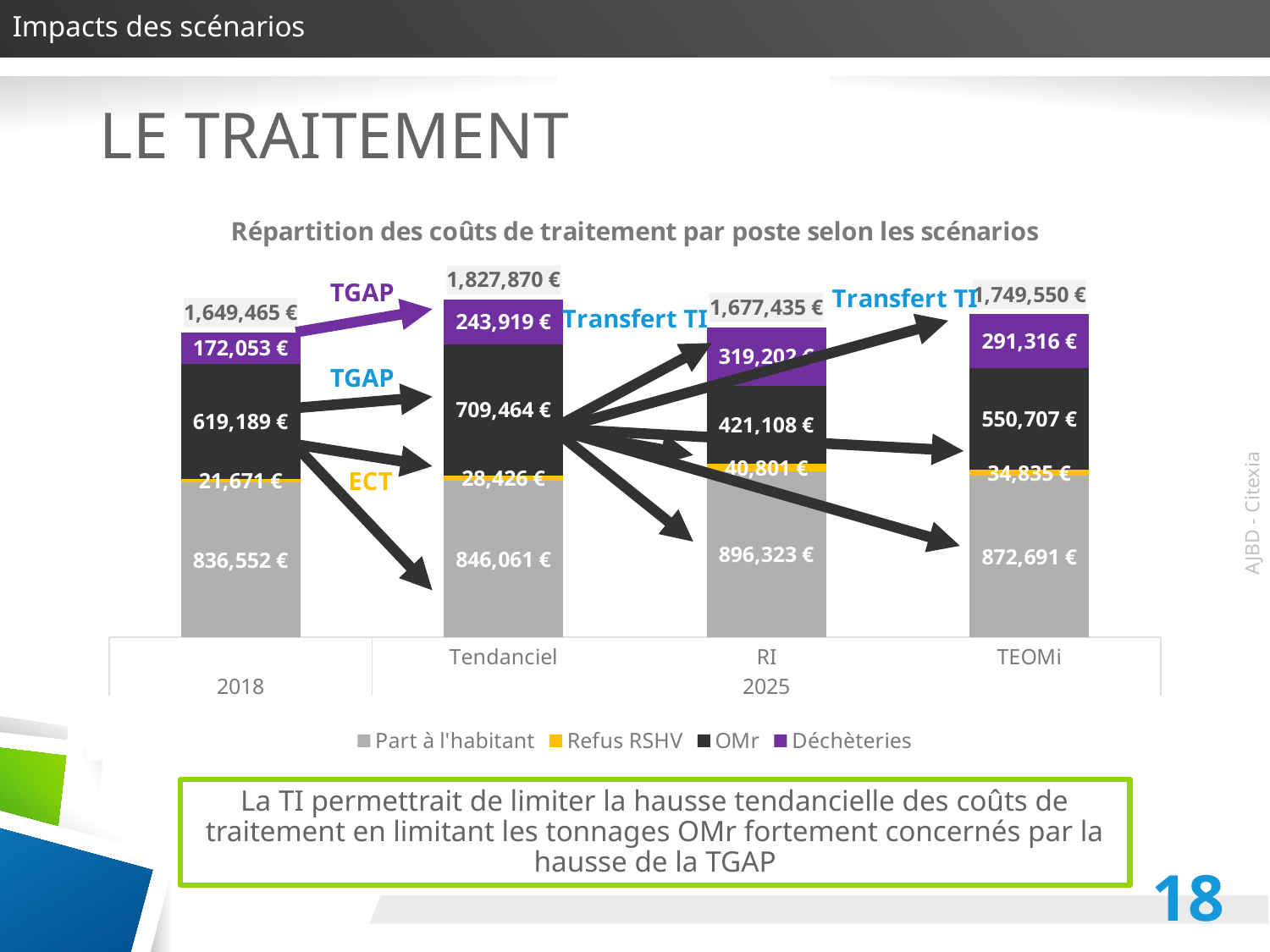
Which bar has the highest total cost? Tendanciel What is the OMr value for the 2018 bar? 619,189 € What is the Déchèteries value for the TEOMi scenario? 291,316 € How many series does the legend list? 4 What is the Part à l'habitant value for the RI scenario? 896,323 € What is the difference between the OMr value for Tendanciel and the OMr value for 2018? 90,275 € Which scenario has the lowest OMr value? RI What is the Refus RSHV value for the Tendanciel scenario? 28,426 € What is the total cost shown above the Tendanciel bar? 1,827,870 € What is the title of the chart? Répartition des coûts de traitement par poste selon les scénarios How many bars are plotted in the chart? 4 Which is larger, the Part à l'habitant value for TEOMi or for RI? RI